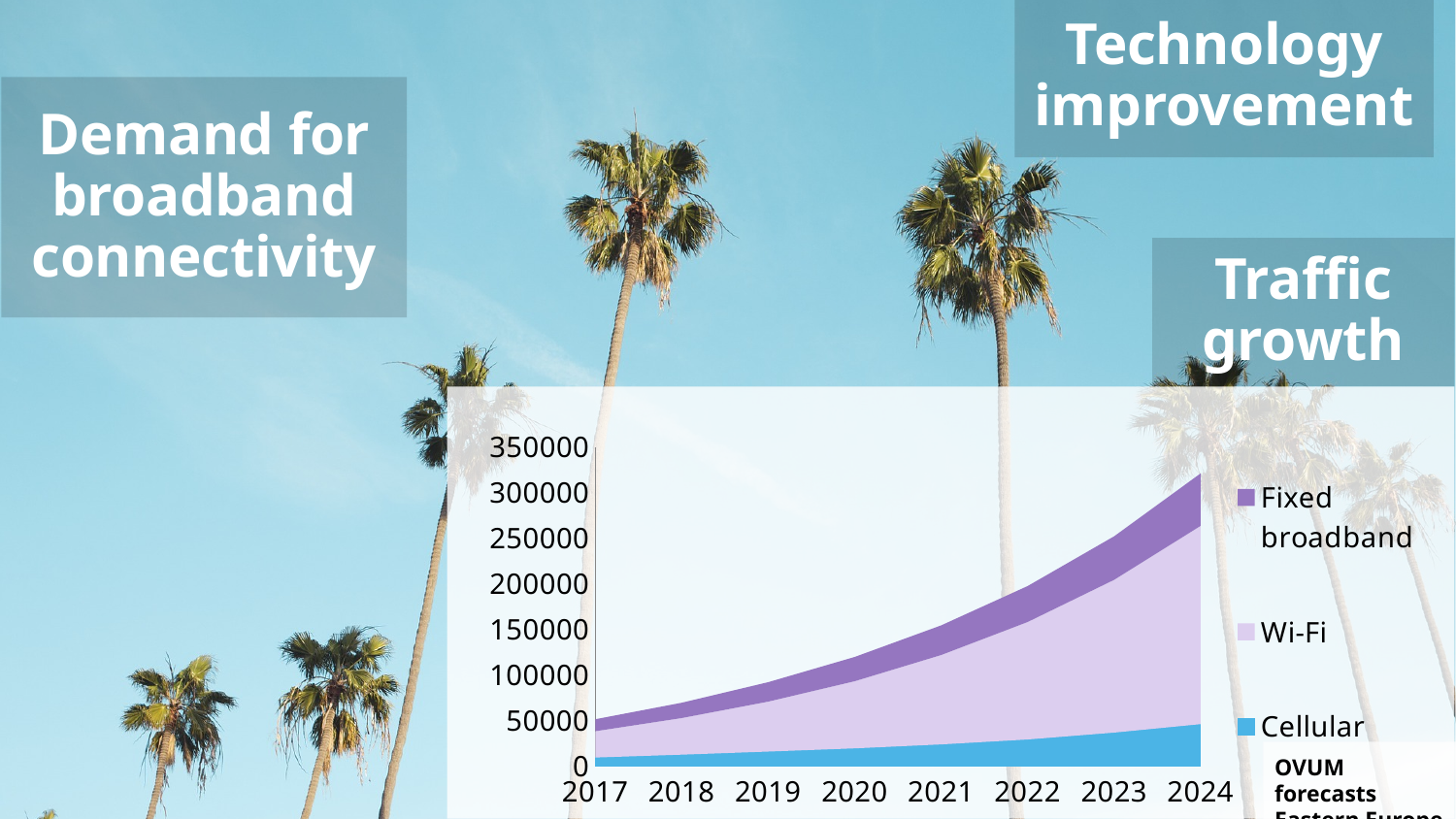
Which years does the chart cover, from first to last? 2017 to 2024 How many series does the chart's legend list? 3 Is the total value for 2017 greater or less than 100000? less In 2024, which series has the larger value: Wi-Fi or Cellular? Wi-Fi Which series contributes the largest share of the total in 2024? Wi-Fi Is the total value for 2021 greater or less than 100000? greater How many years are shown along the x axis of the chart? 8 Which series is plotted at the bottom of the stacked area chart? Cellular Is the total value for 2024 greater or less than 300000? greater What kind of chart is shown on the slide? Stacked area chart Do the total values in the chart rise or fall from 2017 to 2024? Rise